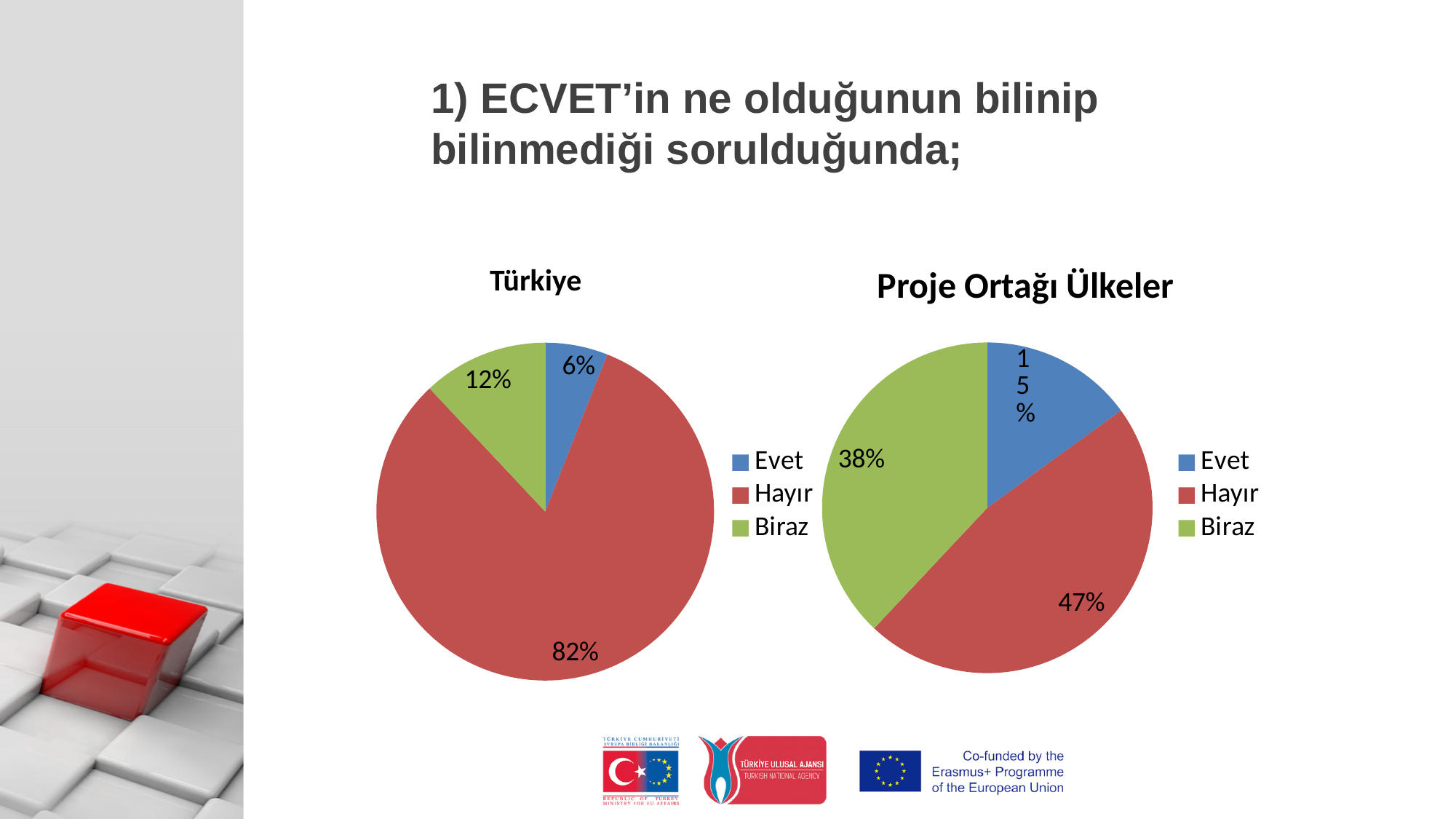
Which is larger: the Hayır share in the "Türkiye" chart or the Hayır share in the "Proje Ortağı Ülkeler" chart? Türkiye In the "Proje Ortağı Ülkeler" chart, which category has the smallest slice? Evet In the "Türkiye" chart, which category has the largest slice? Hayır In the "Proje Ortağı Ülkeler" chart, what percentage is shown for Hayır? 47% In the "Türkiye" chart, what percentage is shown for Hayır? 82% What type of chart is the "Türkiye" chart? Pie chart In the "Türkiye" chart, what percentage is shown for Evet? 6% In the "Türkiye" chart, what percentage is shown for Biraz? 12% In the "Türkiye" chart, which category has the smallest slice? Evet In the "Proje Ortağı Ülkeler" chart, what percentage is shown for Biraz? 38% In the "Proje Ortağı Ülkeler" chart, what is the difference between the Hayır and Biraz percentages? 9% In the "Proje Ortağı Ülkeler" chart, what percentage is shown for Evet? 15%